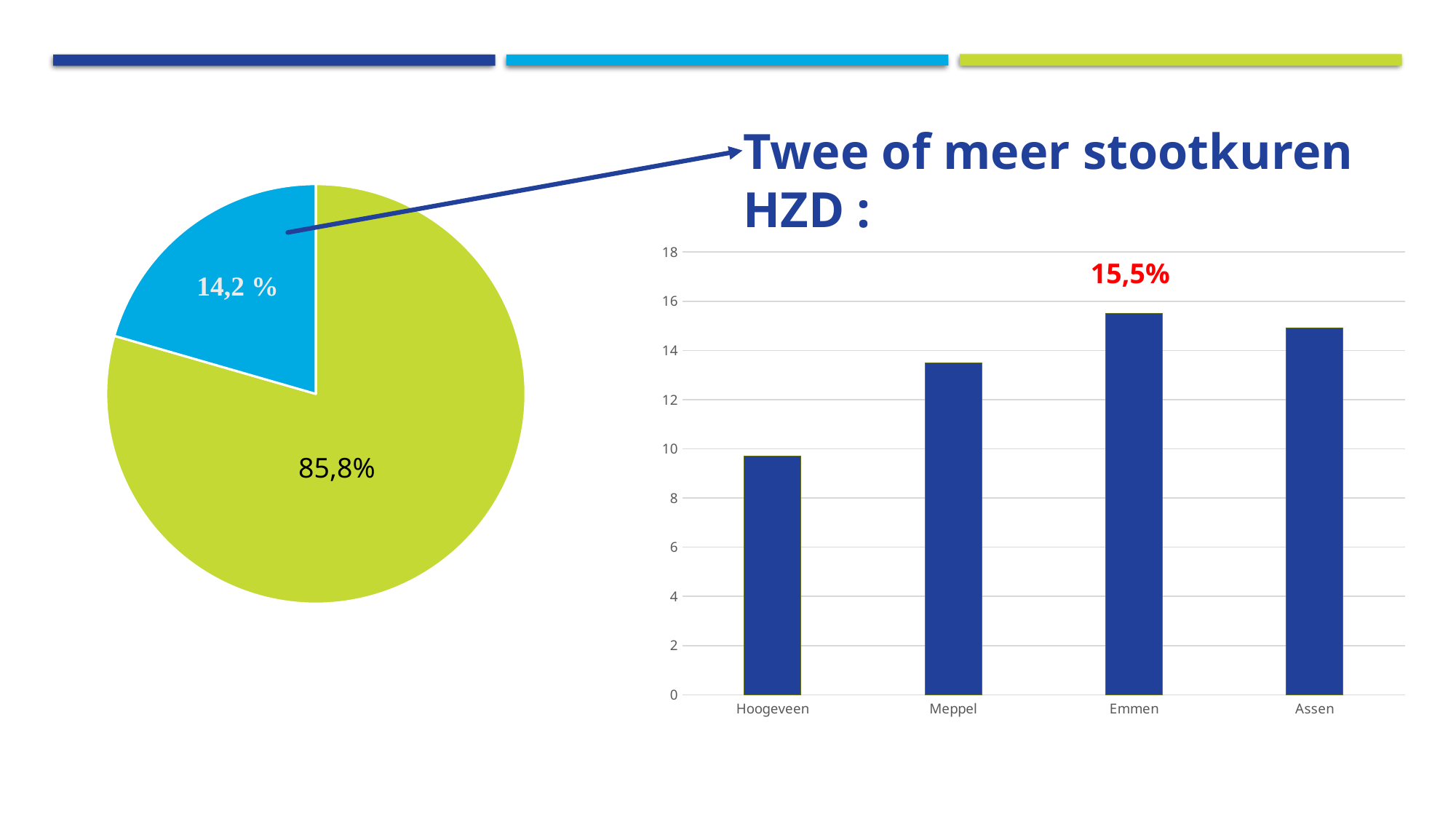
In the chart 'Twee of meer stootkuren HZD :', how many categories are shown on the x axis? 4 In the pie chart on the left, what value is shown for the blue slice? 14,2 % In the pie chart on the left, how many slices are there? 2 In the pie chart on the left, what value is shown for the green slice? 85,8% In the pie chart on the left, which slice is larger, the blue one or the green one? the green one What kind of chart is the chart on the left of the slide? pie chart In the chart 'Twee of meer stootkuren HZD :', which is larger, the value for Meppel or the value for Assen? Assen In the chart 'Twee of meer stootkuren HZD :', which category has the highest bar? Emmen What kind of chart is the chart titled 'Twee of meer stootkuren HZD :'? bar chart In the chart 'Twee of meer stootkuren HZD :', which category has the lowest bar? Hoogeveen In the chart 'Twee of meer stootkuren HZD :', what value is labelled for Emmen? 15,5% In the chart 'Twee of meer stootkuren HZD :', is the value for Hoogeveen greater or less than 10? less